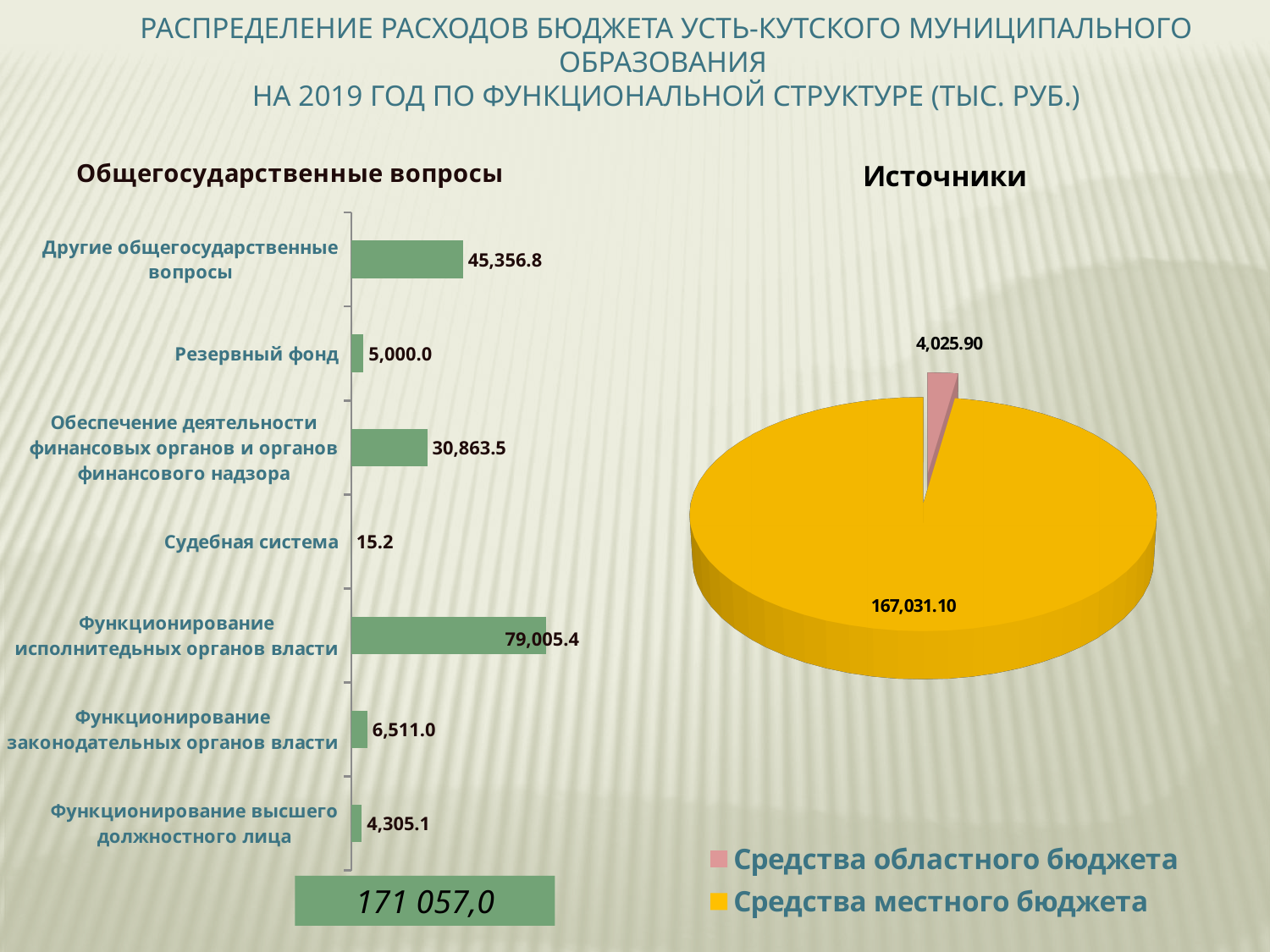
In the bar chart 'Общегосударственные вопросы', what is the value for 'Судебная система'? 15.2 In the pie chart 'Источники', what colour is the slice for 'Средства местного бюджета'? Yellow In the bar chart 'Общегосударственные вопросы', what is the value for 'Резервный фонд'? 5,000.0 In the pie chart 'Источники', what is the value for 'Средства местного бюджета'? 167,031.10 In the bar chart 'Общегосударственные вопросы', which category has the lowest value? Судебная система In the bar chart 'Общегосударственные вопросы', which category has the highest value? Функционирование исполнитедьных органов власти How many entries does the legend of the pie chart 'Источники' list? 2 In the bar chart 'Общегосударственные вопросы', what is the difference between 'Функционирование исполнительных органов власти' and 'Другие общегосударственные вопросы'? 33,648.6 In the pie chart 'Источники', what is the value for 'Средства областного бюджета'? 4,025.90 In the bar chart 'Общегосударственные вопросы', which is larger: 'Функционирование законодательных органов власти' or 'Функционирование высшего должностного лица'? Функционирование законодательных органов власти What type of chart is 'Общегосударственные вопросы'? Bar chart How many categories are shown in the bar chart 'Общегосударственные вопросы'? 7